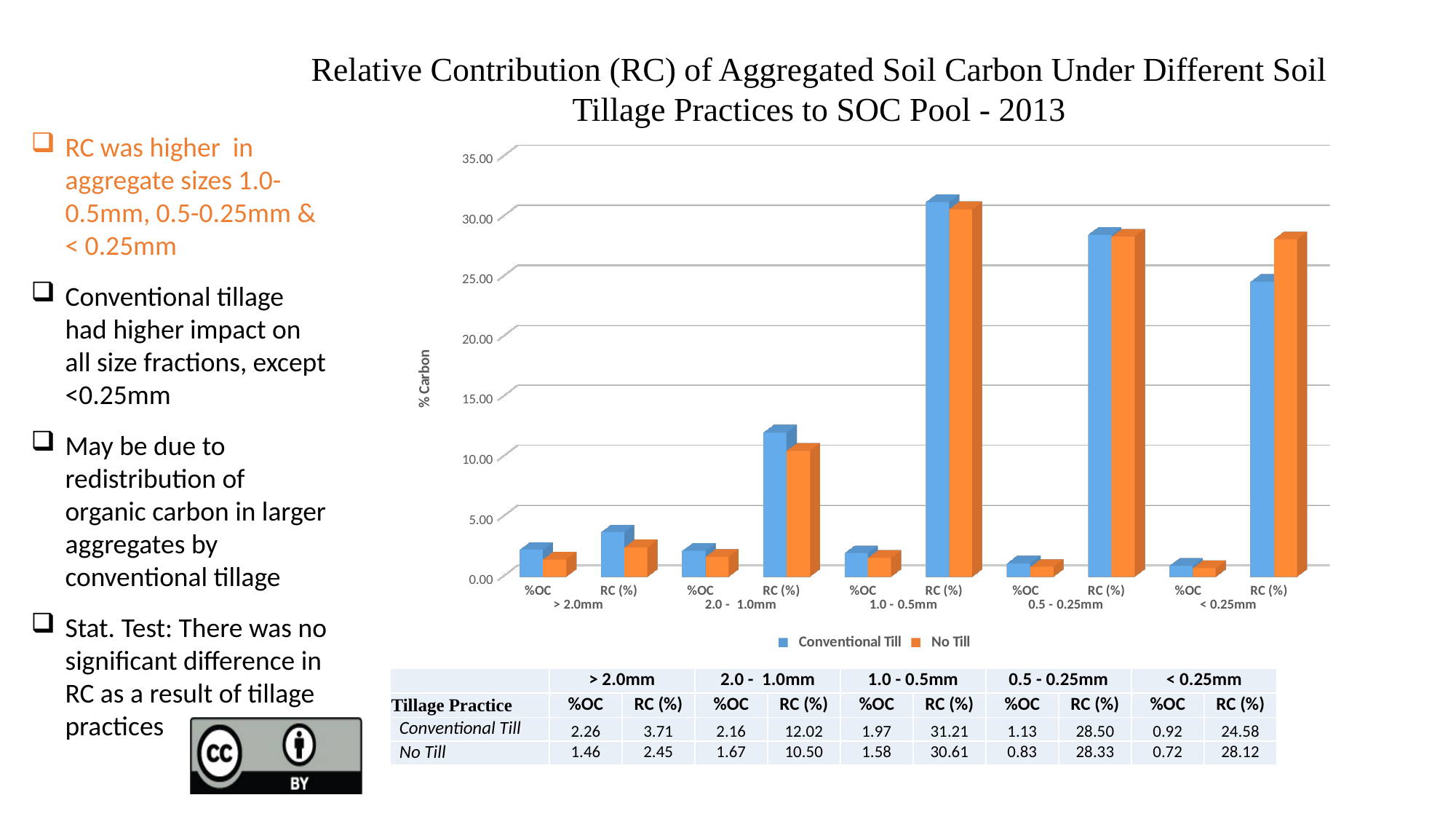
What is the RC (%) value for No Till in the < 0.25mm aggregate size? 28.12 How many series does the chart legend list? 2 Which bar in the chart has the highest value? Conventional Till RC (%) at 1.0 - 0.5mm What is the difference between the Conventional Till and No Till %OC values in the > 2.0mm aggregate size? 0.80 What is the %OC value for No Till in the > 2.0mm aggregate size? 1.46 What is the RC (%) value for Conventional Till in the 1.0 - 0.5mm aggregate size? 31.21 What is the difference between the Conventional Till and No Till RC (%) values in the 2.0 - 1.0mm aggregate size? 1.52 What type of chart is shown on the slide? bar chart For RC (%) in the < 0.25mm aggregate size, which is larger: Conventional Till or No Till? No Till What is the label on the y axis of the chart? % Carbon How many aggregate size fractions are shown along the x axis of the chart? 5 Is the Conventional Till RC (%) value for 0.5 - 0.25mm greater or less than 25.00? greater